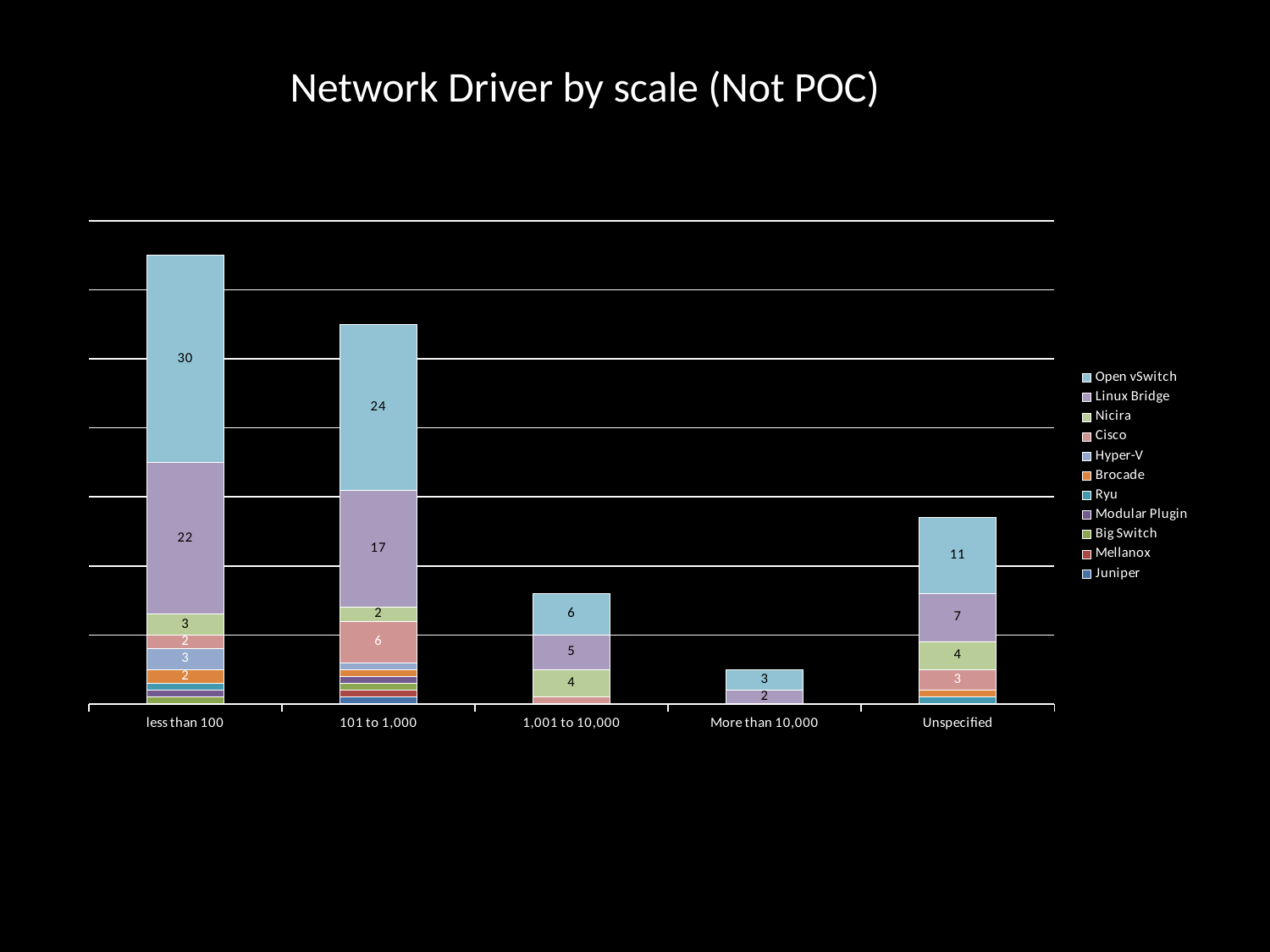
Which category has the lowest labelled Open vSwitch value? More than 10,000 What is the Open vSwitch value for the 'Unspecified' category? 11 What is the Linux Bridge value for the 'More than 10,000' category? 2 How many series does the legend list? 11 Which category has the highest Open vSwitch value? less than 100 Which is larger: the Linux Bridge value for '1,001 to 10,000' or for 'Unspecified'? Unspecified How many categories are shown on the x axis? 5 What is the Linux Bridge value for the '101 to 1,000' category? 17 What is the Open vSwitch value for the 'less than 100' category? 30 What is the difference between the Open vSwitch values for 'less than 100' and '101 to 1,000'? 6 What kind of chart is shown on the slide? Stacked bar chart What is the title of the chart? Network Driver by scale (Not POC)